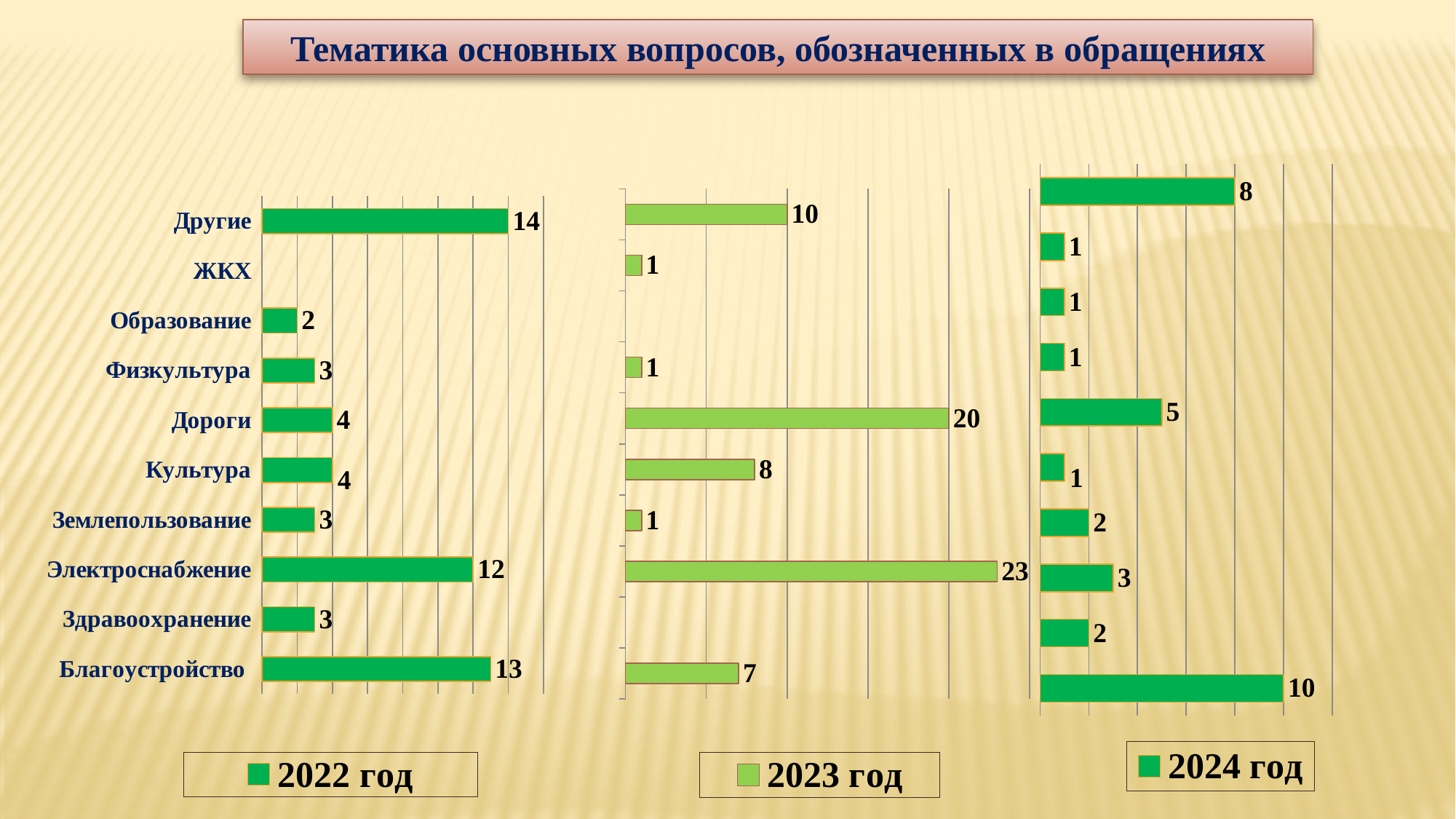
In the 2022 год chart, which category has the highest value? Другие In the 2023 год chart, what is the value for Дороги? 20 In the 2022 год chart, which is larger, the value for Благоустройство or the value for Образование? Благоустройство In the 2023 год chart, what is the difference between the values for Электроснабжение and Дороги? 3 How many categories are listed on the vertical axis of the 2022 год chart? 10 In the 2022 год chart, what is the value for Электроснабжение? 12 In the 2022 год chart, what is the difference between the values for Другие and Благоустройство? 1 In the 2023 год chart, which category has the highest value? Электроснабжение In the 2022 год chart, what is the value for Другие? 14 What type of chart is the 2023 год chart? bar chart In the 2023 год chart, which is larger, the value for Другие or the value for Культура? Другие What is the title of the slide? Тематика основных вопросов, обозначенных в обращениях